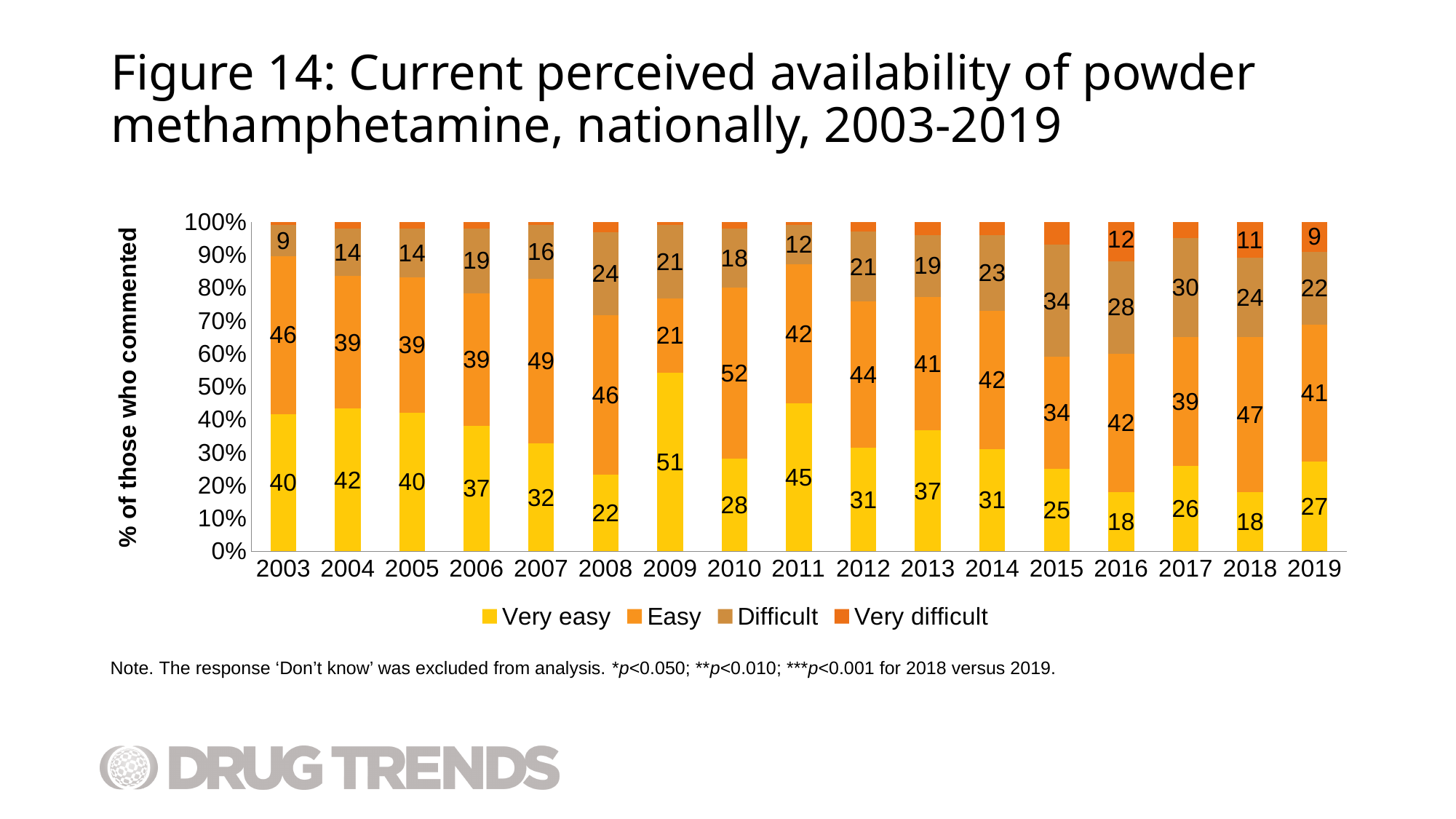
What is the 'Difficult' value for 2008? 24 What is the difference between the 'Very easy' values for 2003 and 2019? 13 What kind of chart is shown on the slide? Stacked bar chart What is the 'Very difficult' value for 2016? 12 In which year is the 'Easy' value highest? 2010 What is the 'Very easy' value for 2009? 51 How many series does the legend list? 4 How many years are shown along the x axis? 17 Did the 'Very easy' value rise or fall from 2018 to 2019? Rise What is the 'Easy' value for 2007? 49 Which year has the larger 'Difficult' value, 2015 or 2017? 2015 In which year is the 'Very easy' value highest? 2009